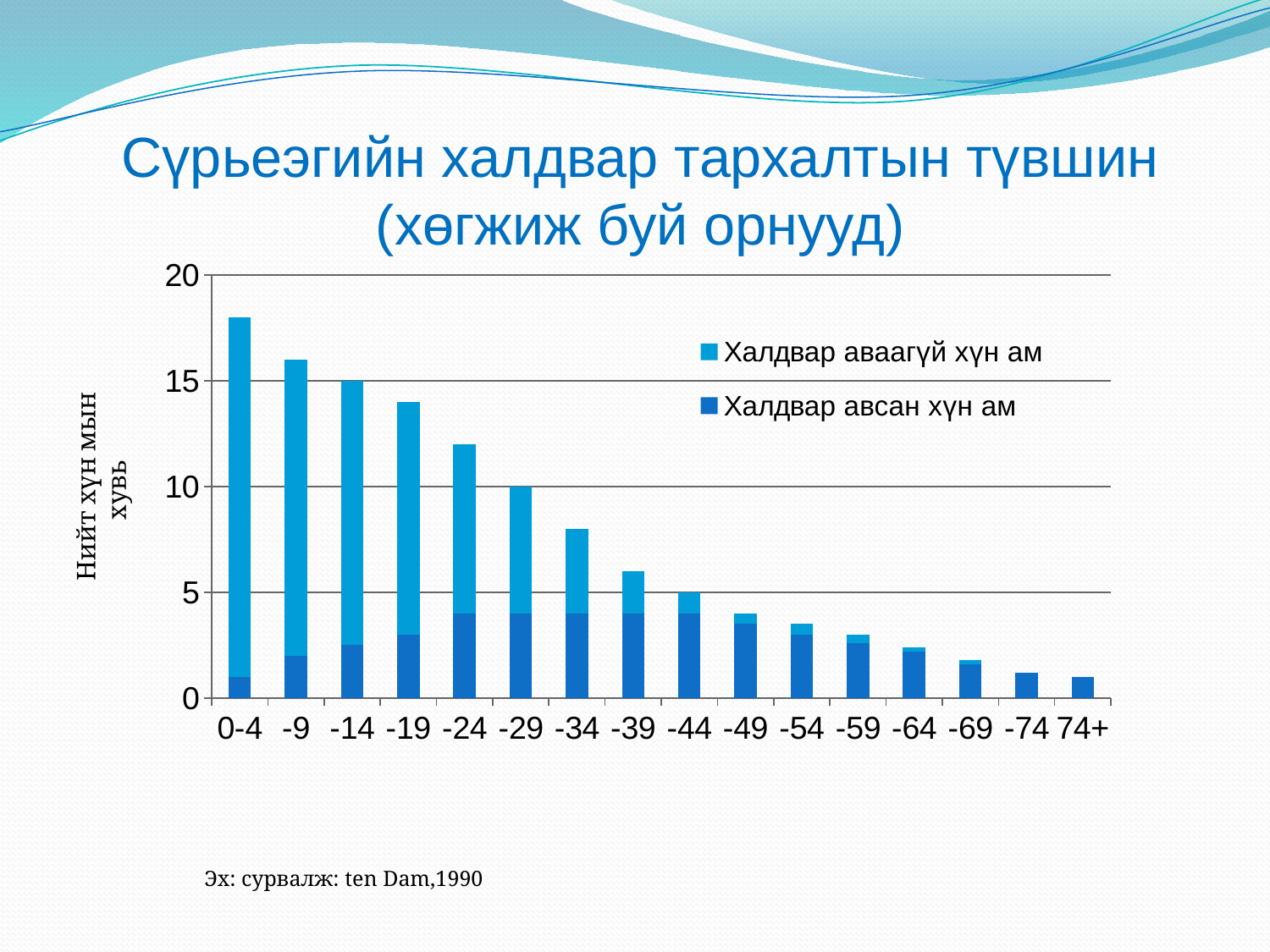
How many series does the legend list? 2 How many age-group categories are shown on the x axis? 16 Which legend entry is shown in the darker blue colour? Халдвар авсан хүн ам Which total bar is taller, the one for -9 or the one for -39? -9 Is the total bar for the 0-4 age group greater or less than 15? greater Is the total bar for the -54 age group greater or less than 5? less What is the label of the y axis? Нийт хүн амын хувь Is the total bar for the -34 age group greater or less than 10? less Which age group has the tallest total bar? 0-4 Do the total bar heights rise or fall moving from left to right along the x axis? fall What type of chart is shown on the slide? stacked bar chart